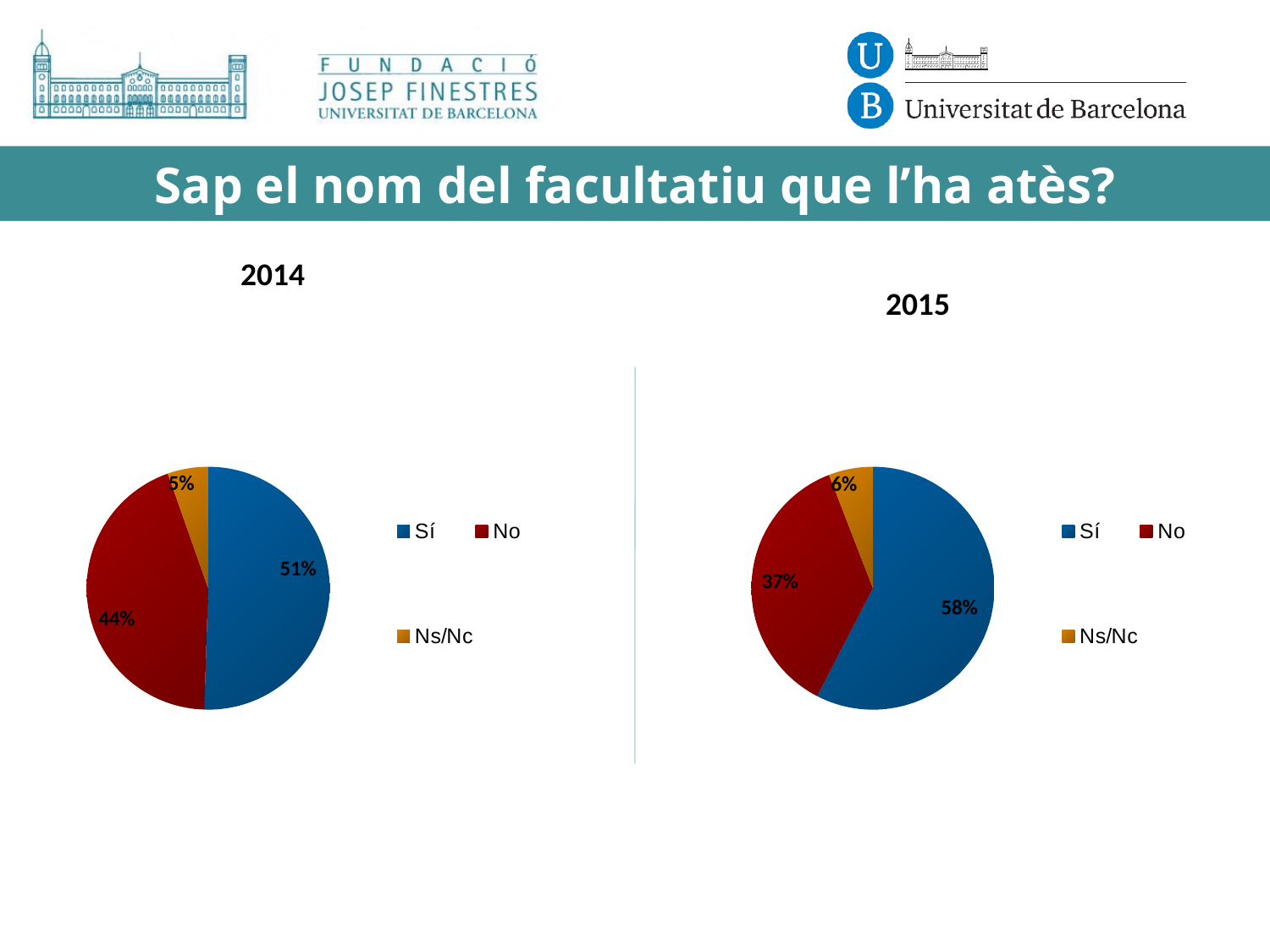
How many categories does the 2015 pie chart show? 3 In the 2014 pie chart, which is larger, the Sí share or the No share? Sí In the 2015 pie chart, what percentage answered Ns/Nc? 6% In the 2015 pie chart, what percentage answered Sí? 58% In the 2015 pie chart, what is the difference between the Sí and No shares? 21% In the 2015 pie chart, which category has the largest share? Sí In the 2014 pie chart, what colour is the Ns/Nc slice? Orange In the 2014 pie chart, what percentage answered Sí? 51% In the 2014 pie chart, what percentage answered No? 44% In the 2015 pie chart, what share of the pie does the No slice represent? 37% What type of chart is used for the 2014 data? Pie chart In the 2014 pie chart, which category has the smallest share? Ns/Nc